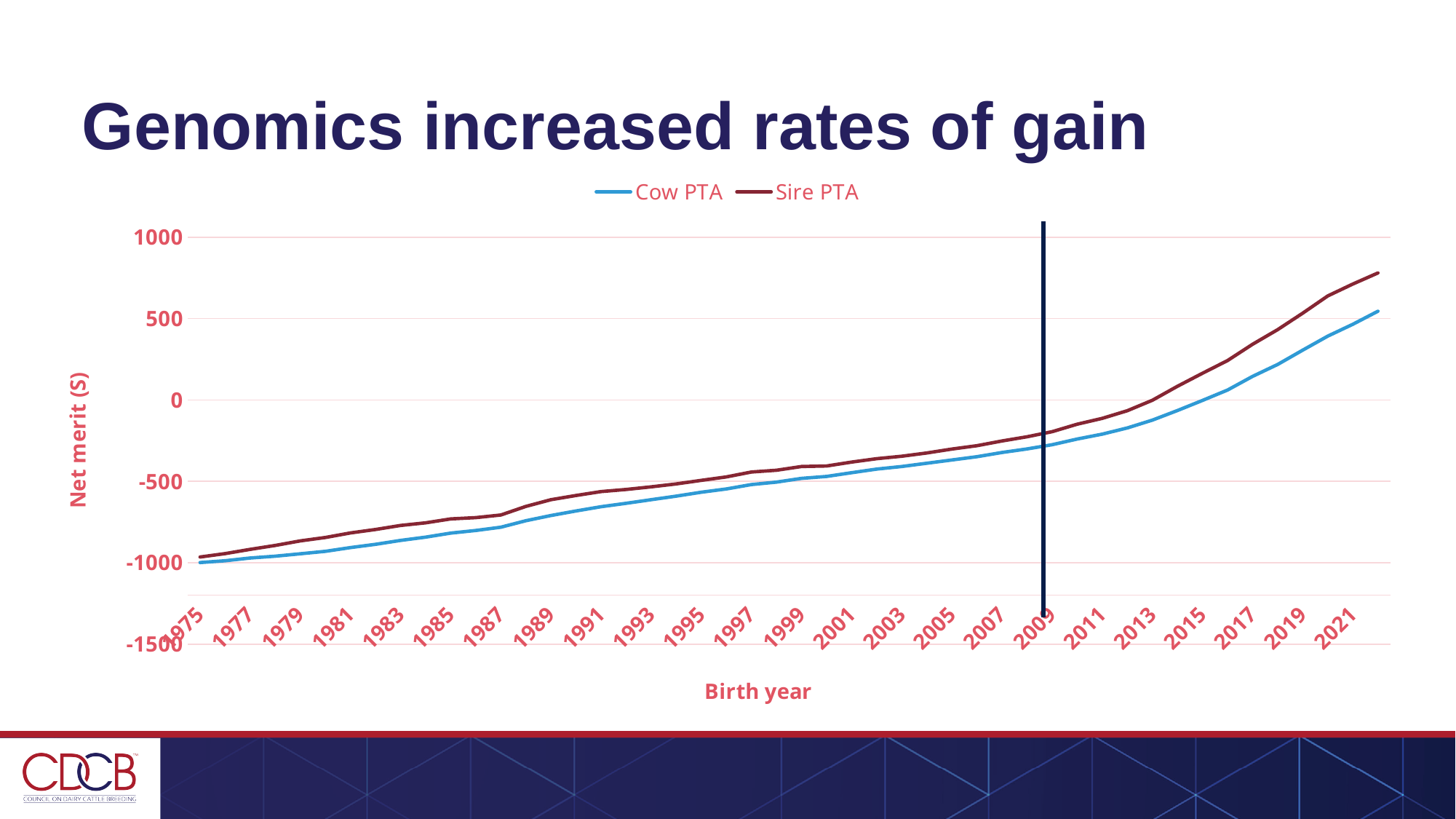
Do the Cow PTA values rise or fall from 1975 to 2021? rise Is the Sire PTA value for 1985 greater or less than -500? less Which series has the higher values across the whole chart? Sire PTA Is the Cow PTA value for 2013 greater or less than 0? less Which series is higher in 2021, Cow PTA or Sire PTA? Sire PTA What is the label of the y axis? Net merit ($) Is the Sire PTA value for 2009 greater or less than -500? greater How many series does the legend list? 2 What is the title of the slide? Genomics increased rates of gain What kind of chart is shown on the slide? line chart